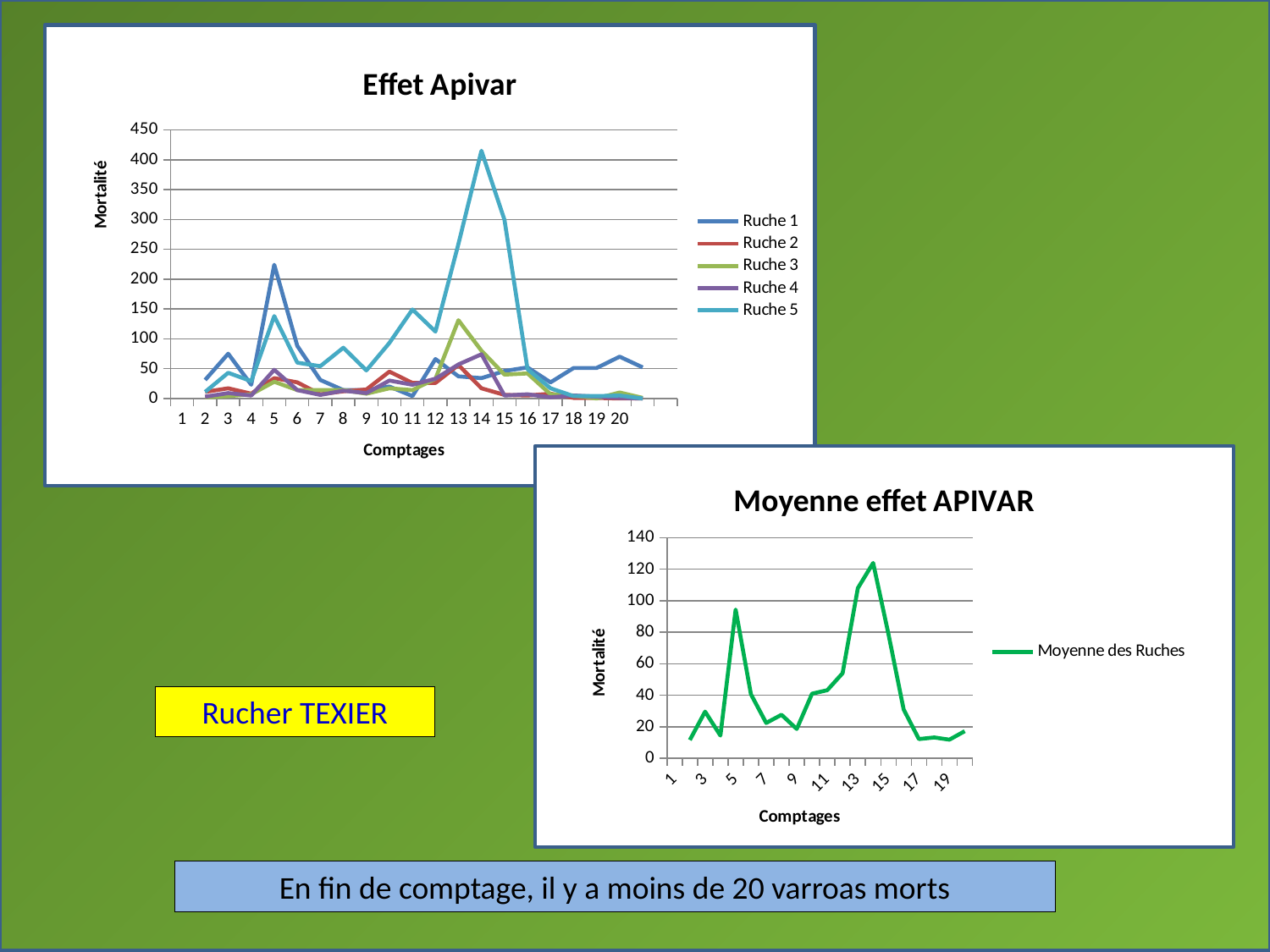
In the "Effet Apivar" chart, is the value for Ruche 5 at comptage 14 greater or less than 400? greater In the "Moyenne effet APIVAR" chart, is the peak value at comptage 14 greater or less than 100? greater In the "Effet Apivar" chart, is the value for Ruche 1 at comptage 5 greater or less than 200? greater In the "Effet Apivar" chart, at comptage 14, which is larger: Ruche 5 or Ruche 1? Ruche 5 In the "Moyenne effet APIVAR" chart, what is the name of the series shown in the legend? Moyenne des Ruches What kind of chart is "Effet Apivar"? Line chart In the "Moyenne effet APIVAR" chart, do the values rise or fall between comptage 14 and comptage 17? fall In the "Effet Apivar" chart, which series reaches the highest mortality value? Ruche 5 In the "Effet Apivar" chart, how many comptages are labelled on the x axis? 20 In the "Effet Apivar" chart, how many series does the legend list? 5